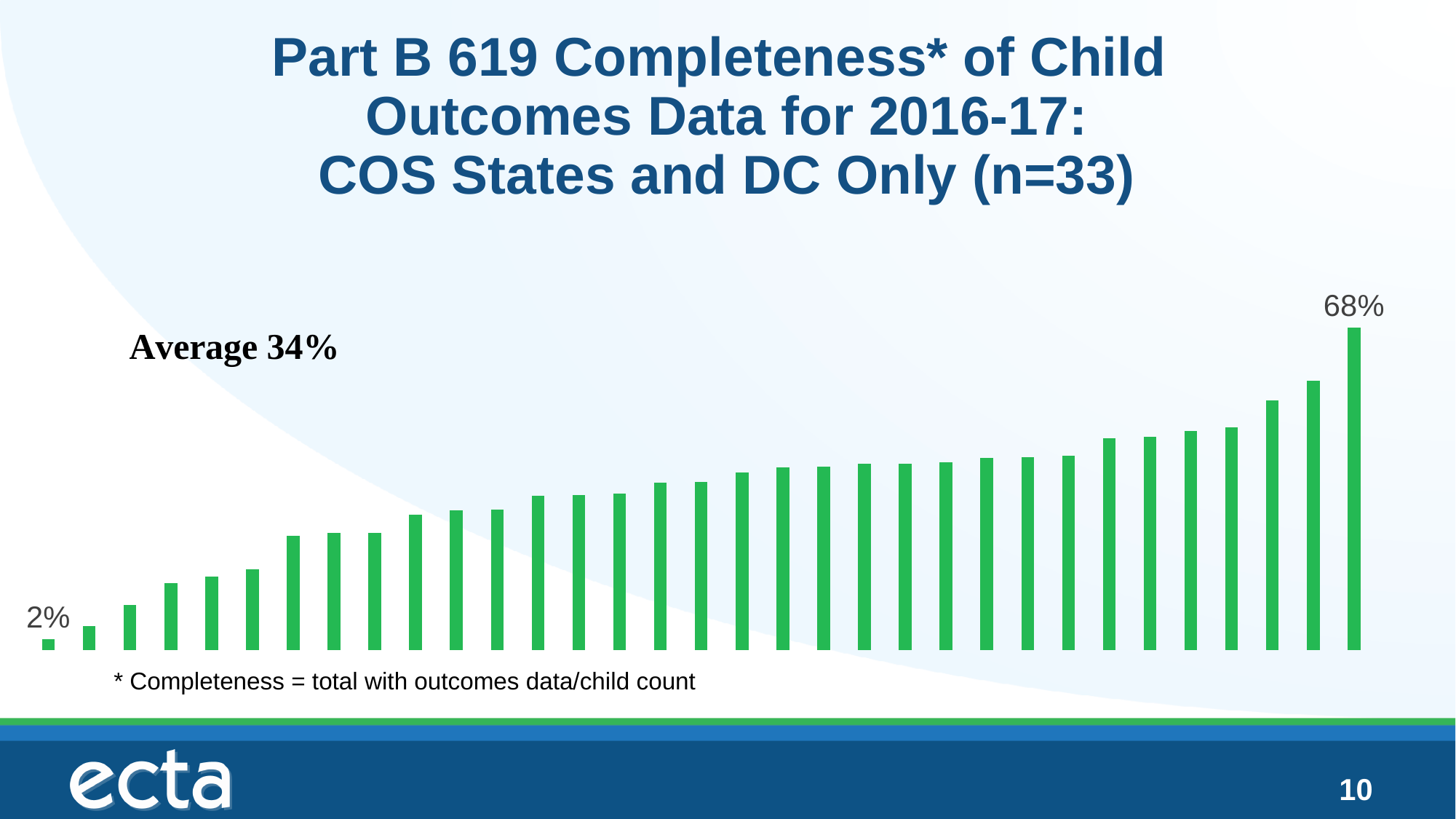
What colour are the bars in the chart? green What is the highest value shown in the chart? 68% What is the lowest value shown in the chart? 2% What is the difference between the highest labelled value (68%) and the lowest labelled value (2%) in the chart? 66 percentage points What average value is annotated on the chart? 34% Is the tallest bar in the chart larger or smaller than the shortest bar? larger Do the bar values rise or fall from left to right across the chart? rise What kind of chart is shown on the slide? bar chart How many bars (states) are plotted in the chart? 33